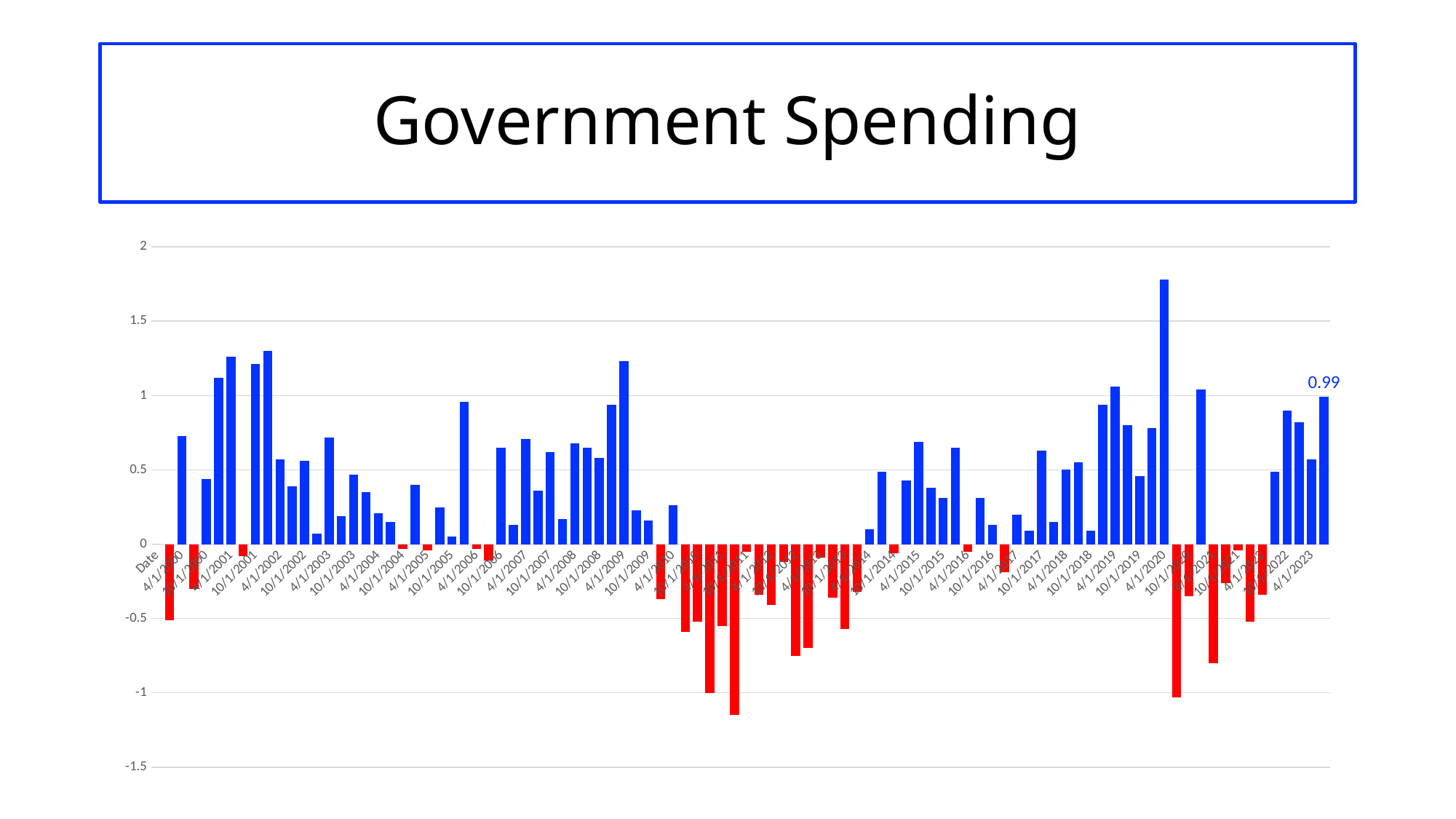
Is the value of the rightmost bar greater or less than 1? less Do the bars in the 2010 to 2013 region of the chart lie mostly above or below zero? below What colour are the bars with negative values? red Is the value of the rightmost bar greater or less than 0.5? greater Which is larger, the value of the tallest bar near 2020 or the value of the rightmost bar labelled 0.99? the tallest bar near 2020 What kind of chart is shown on the slide? bar chart Is the value of the lowest bar on the chart greater or less than -1? less What value is printed as a data label on the rightmost bar of the chart? 0.99 What is the title of the chart? Government Spending